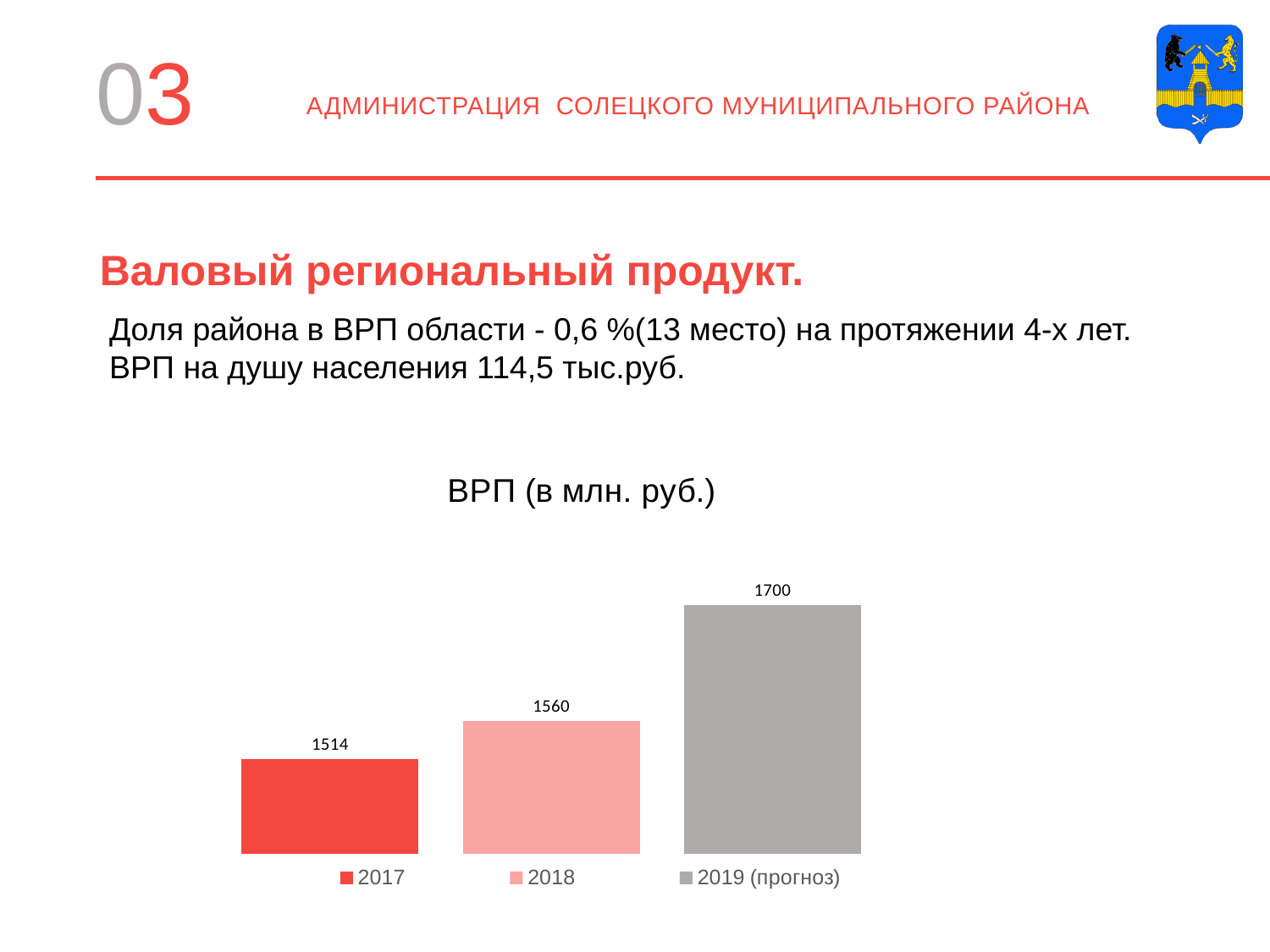
Do the values in the chart 'ВРП (в млн. руб.)' rise or fall from 2017 to 2019 (прогноз)? rise What is the difference between the 2019 (прогноз) value and the 2017 value in the chart 'ВРП (в млн. руб.)'? 186 What is the value for 2019 (прогноз) in the chart 'ВРП (в млн. руб.)'? 1700 Which is larger in the chart 'ВРП (в млн. руб.)': the value for 2018 or the value for 2019 (прогноз)? 2019 (прогноз) How many bars are shown in the chart 'ВРП (в млн. руб.)'? 3 Which year has the highest value in the chart 'ВРП (в млн. руб.)'? 2019 (прогноз) What is the difference between the 2018 value and the 2017 value in the chart 'ВРП (в млн. руб.)'? 46 What kind of chart is 'ВРП (в млн. руб.)'? bar chart Which year has the lowest value in the chart 'ВРП (в млн. руб.)'? 2017 What is the value for 2018 in the chart 'ВРП (в млн. руб.)'? 1560 How many entries does the legend of the chart 'ВРП (в млн. руб.)' list? 3 What is the value for 2017 in the chart 'ВРП (в млн. руб.)'? 1514